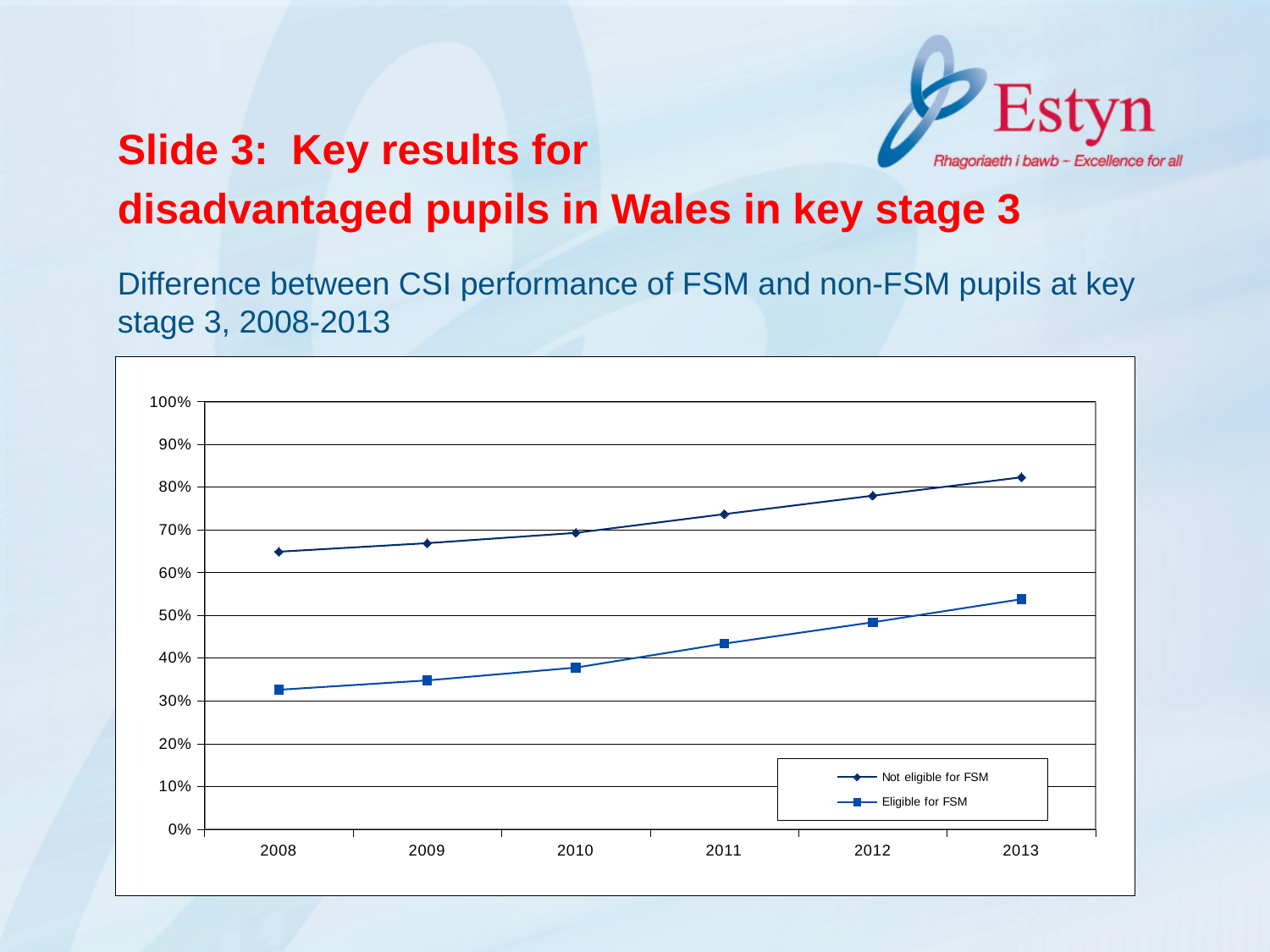
What are the two series named in the legend? Not eligible for FSM and Eligible for FSM In which year is the Not eligible for FSM value highest? 2013 How many series does the legend list? 2 Is the Not eligible for FSM value for 2013 greater or less than 80%? greater Does the Eligible for FSM line rise or fall from 2008 to 2013? rise Is the Eligible for FSM value for 2013 greater or less than 50%? greater How many years are plotted along the x axis? 6 In which year is the Eligible for FSM value lowest? 2008 Which series has the higher value in every year, Not eligible for FSM or Eligible for FSM? Not eligible for FSM Is the Not eligible for FSM value for 2008 greater or less than 60%? greater What kind of chart is shown on the slide? line chart